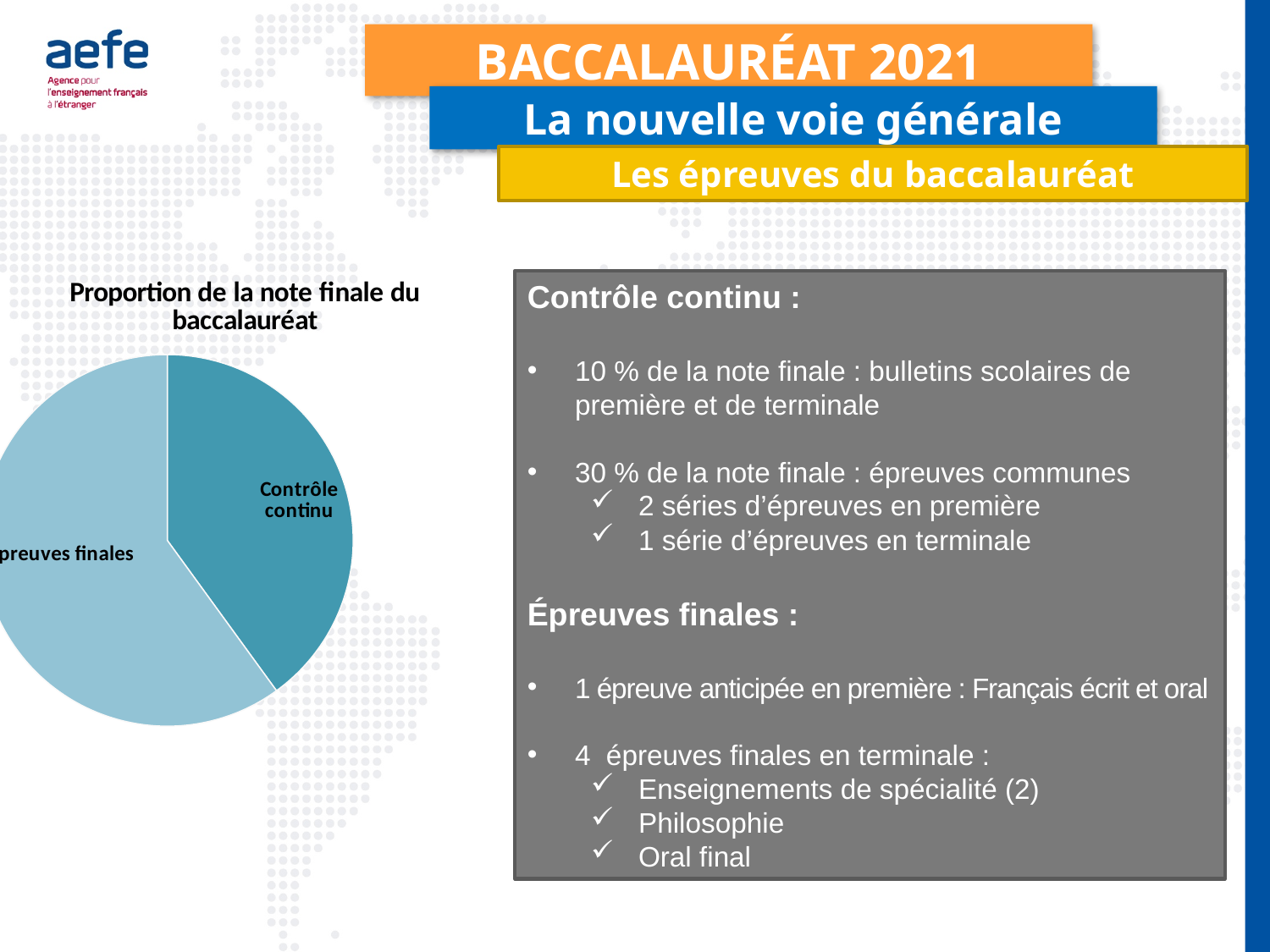
Which slice of the pie chart is the largest? Épreuves finales Which slice of the pie chart is the smallest? Contrôle continu What kind of chart is shown on the slide? Pie chart How many slices does the pie chart have? 2 In the pie chart, which is larger: the Contrôle continu slice or the Épreuves finales slice? Épreuves finales Which slice of the pie chart is drawn in the darker teal colour? Contrôle continu Does the Contrôle continu slice take up more or less than half of the pie chart? Less What is the title of the pie chart? Proportion de la note finale du baccalauréat